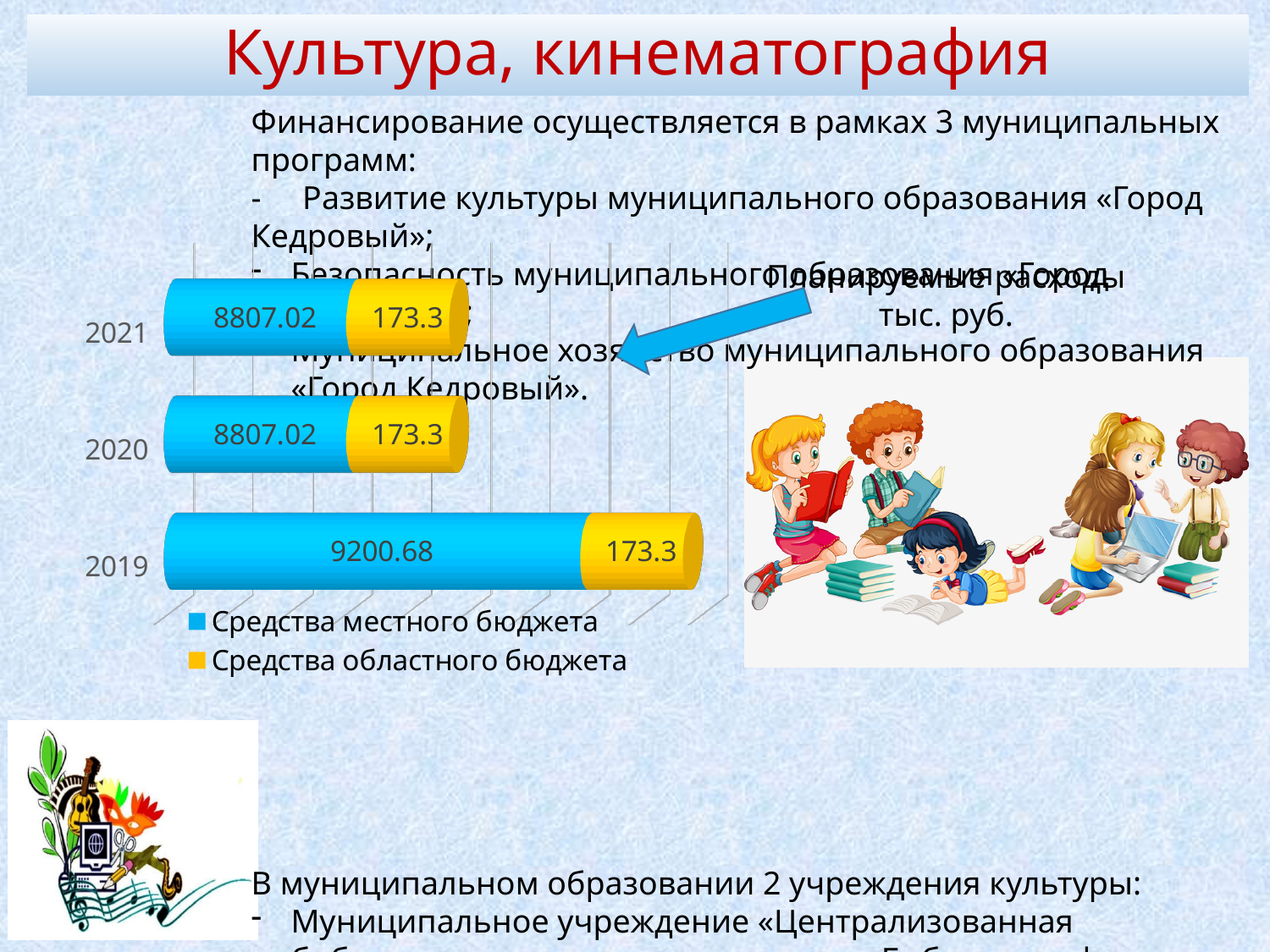
What is the total of the stacked bar for 2020? 8980.32 How many series does the legend list? 2 What is the value for Средства местного бюджета in 2021? 8807.02 Which is larger: Средства местного бюджета in 2019 or in 2021? 2019 What is the value for Средства областного бюджета in 2020? 173.3 What is the total of the stacked bar for 2019? 9373.98 How many years are shown on the chart? 3 What is the value for Средства местного бюджета in 2019? 9200.68 Which colour represents Средства областного бюджета in the chart? Yellow What kind of chart is shown on the slide? Stacked bar chart What is the difference between the Средства местного бюджета values for 2019 and 2020? 393.66 Which year has the highest value for Средства местного бюджета? 2019